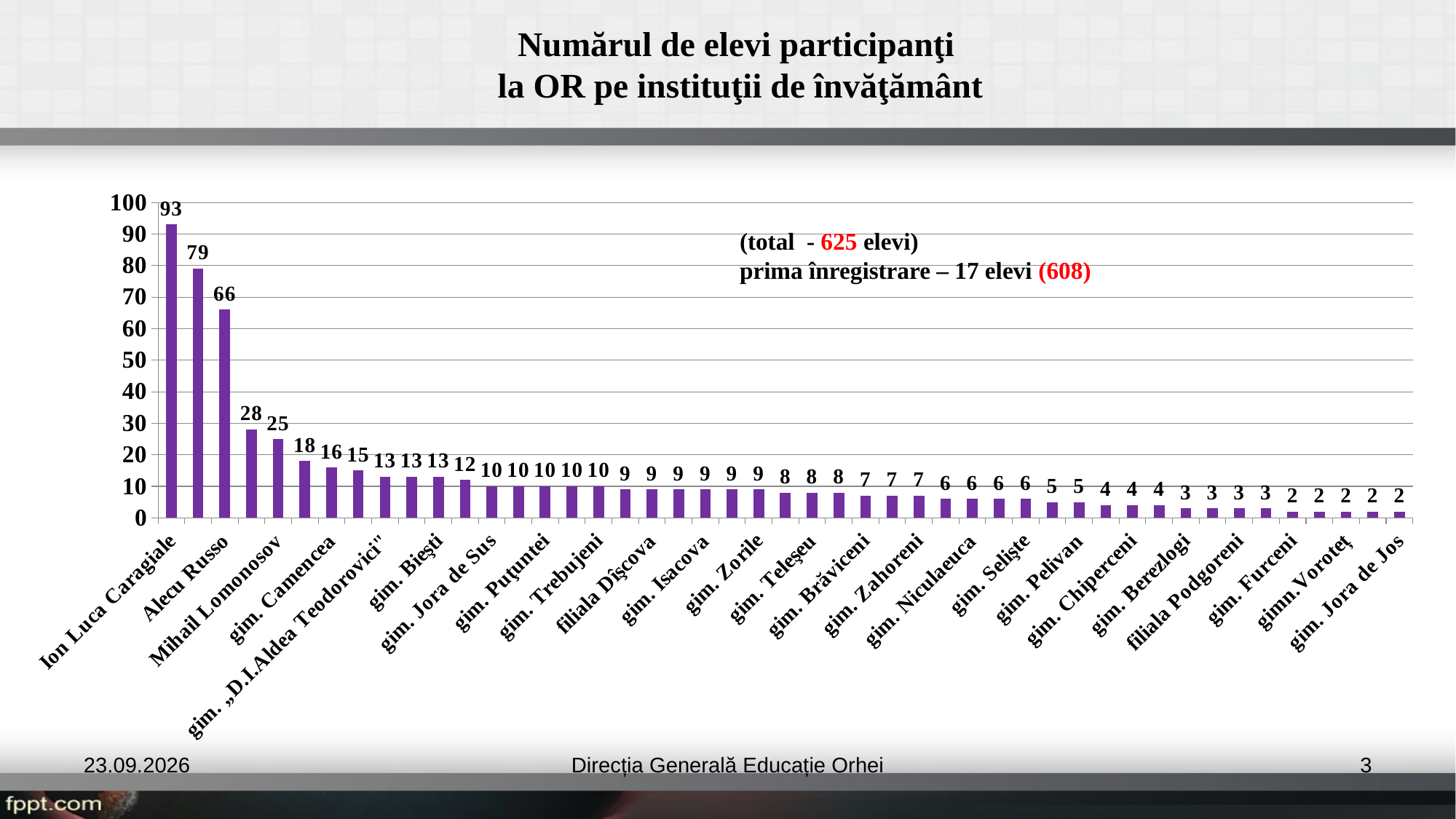
How many participating students are shown for gim. Jora de Jos? 2 What is the highest value shown on the chart? 93 Do the values rise or fall from left to right along the x axis? fall What is the lowest value shown on the chart? 2 How many bars are plotted on the chart? 47 Which has more participating students, Ion Luca Caragiale or gim. Jora de Jos? Ion Luca Caragiale Is the value for Ion Luca Caragiale greater or less than 90? greater What type of chart is shown on the slide? bar chart Which institution has the highest number of participating students? Ion Luca Caragiale According to the text on the chart, what is the total number of students (elevi)? 625 What is the difference between the highest bar (93) and the second highest bar (79)? 14 How many participating students are shown for Ion Luca Caragiale? 93